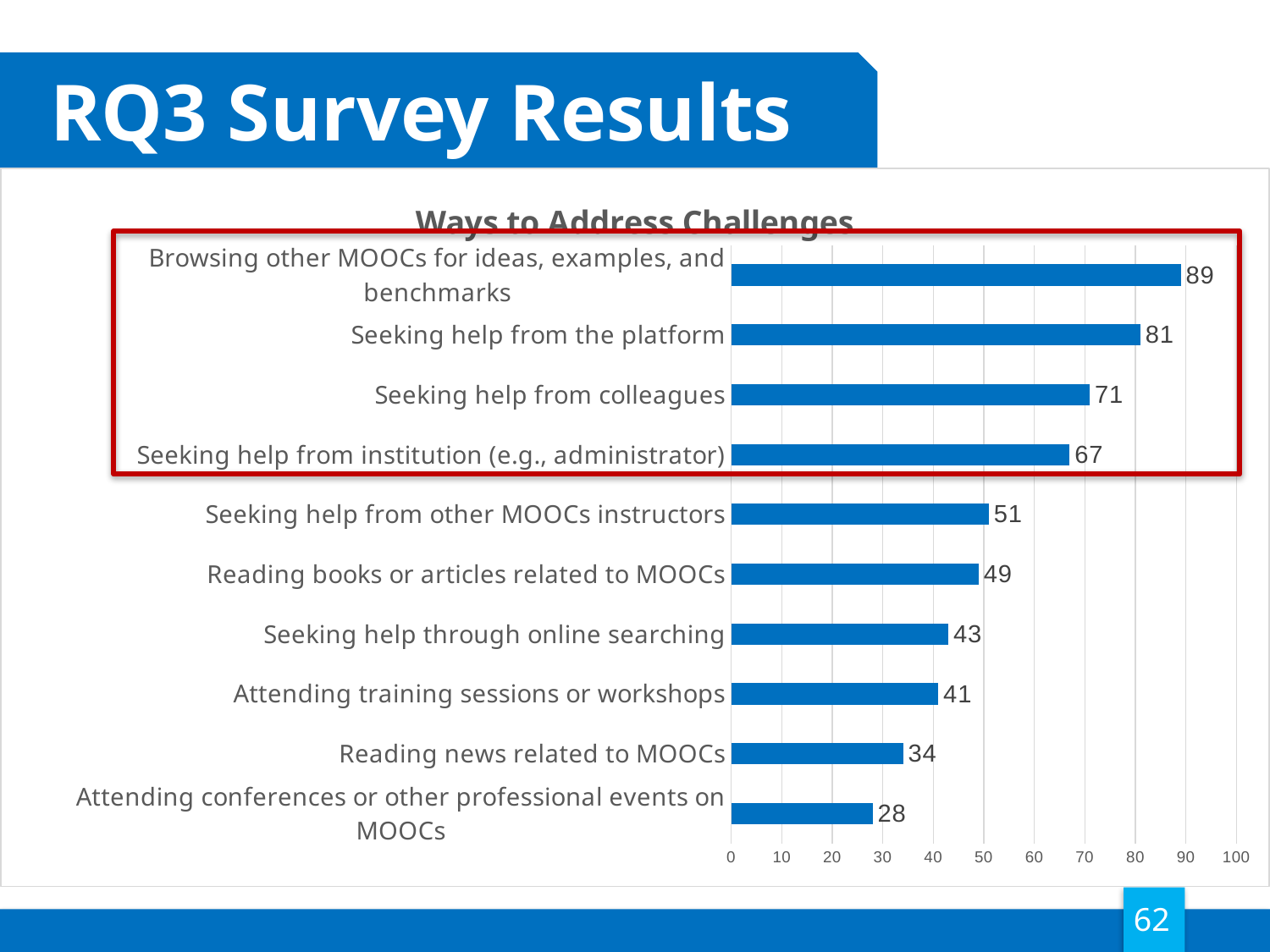
What is the value for "Reading books or articles related to MOOCs"? 49 Which category has the highest value? Browsing other MOOCs for ideas, examples, and benchmarks What is the title of the chart? Ways to Address Challenges What kind of chart is shown on the slide? bar chart What is the value for "Attending training sessions or workshops"? 41 What is the difference between the highest and lowest values in the chart? 61 Is the value for "Seeking help from other MOOCs instructors" greater or less than 60? less Which is larger: the value for "Seeking help through online searching" or the value for "Reading news related to MOOCs"? Seeking help through online searching What is the difference between the values for "Seeking help from colleagues" and "Seeking help from institution (e.g., administrator)"? 4 How many categories are shown in the chart? 10 What is the value for "Seeking help from the platform"? 81 Which category has the lowest value? Attending conferences or other professional events on MOOCs